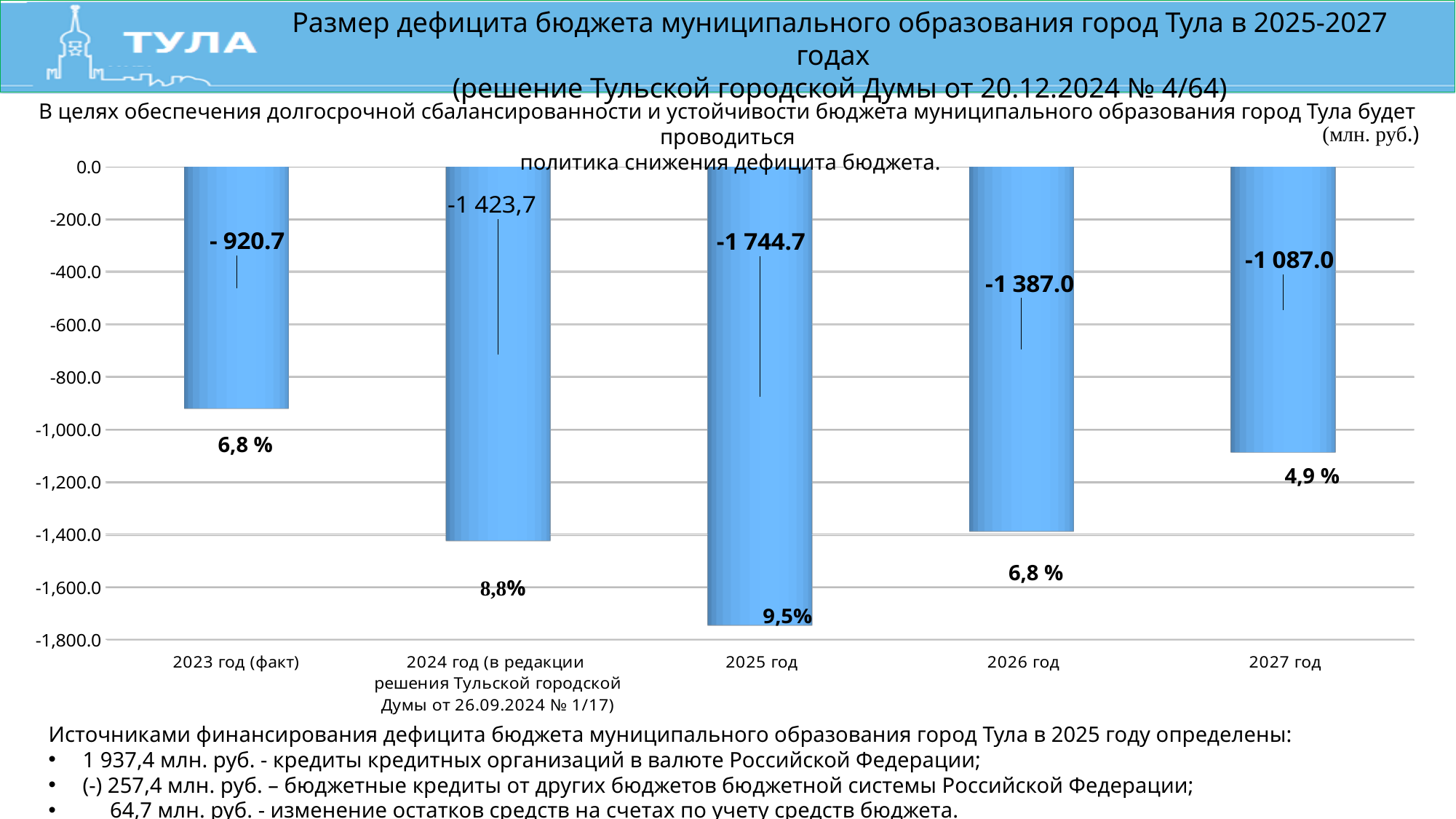
What is the value shown for 2027 год? -1 087.0 What is the value shown for 2023 год (факт)? - 920.7 By how much does the deficit for 2025 год exceed the deficit for 2026 год in absolute terms? 357.7 What percentage is printed below the bar for 2025 год? 9,5% What type of chart is shown on the slide? Bar chart From 2025 год to 2027 год, does the size of the deficit increase or decrease? Decrease Which year has a larger deficit in absolute terms, 2024 год or 2027 год? 2024 год What is the value shown for 2026 год? -1 387.0 Which year has the smallest budget deficit (the value closest to zero)? 2023 год (факт) How many bars (years) are shown on the chart? 5 Which year has the largest budget deficit (the lowest value on the chart)? 2025 год What is the value shown for 2025 год? -1 744.7